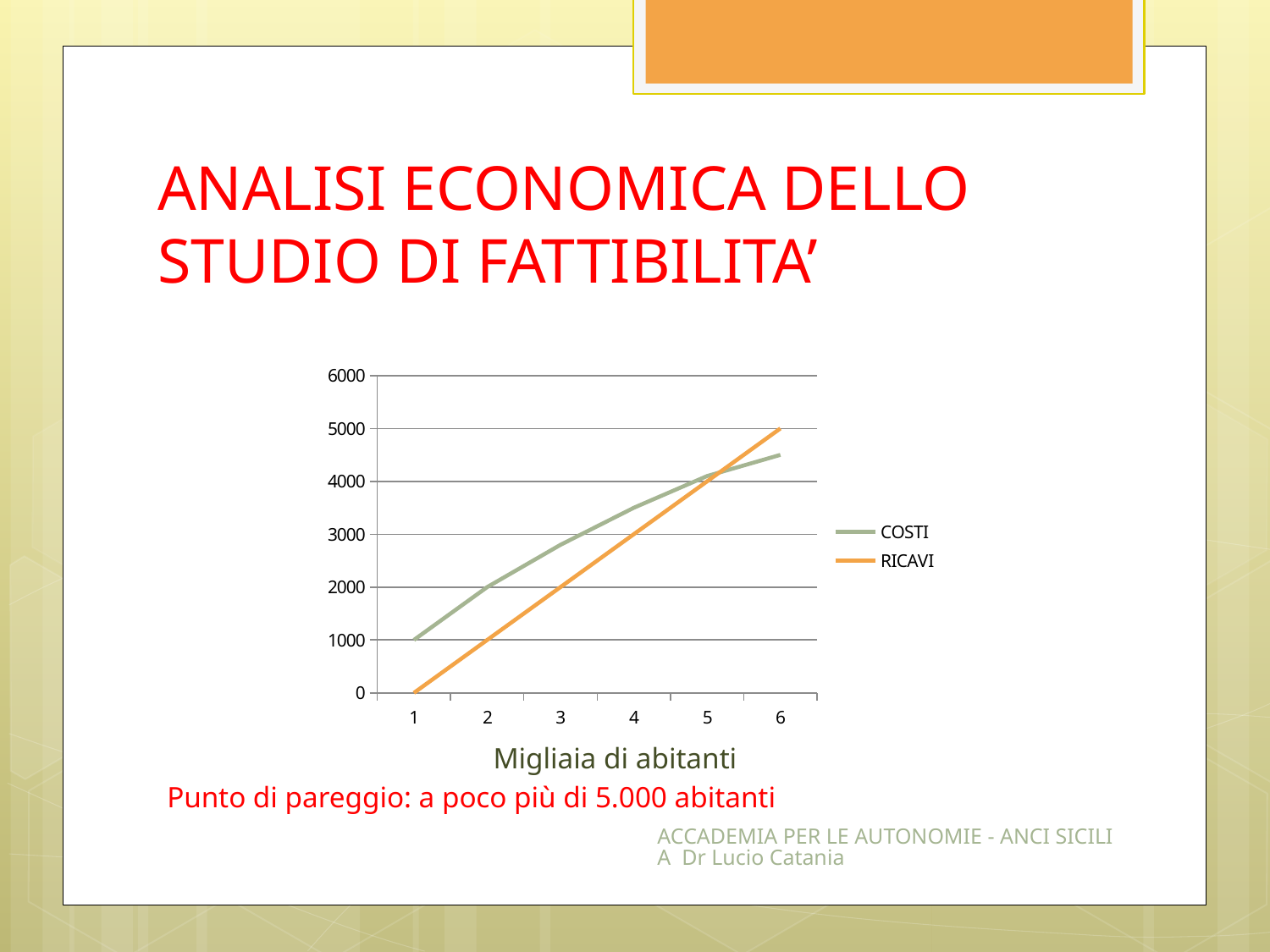
Do the RICAVI values rise or fall as x increases from 1 to 6? rise What is the value of RICAVI at x = 6? 5000 What is the value of COSTI at x = 1? 1000 At x = 2, which series has the larger value, COSTI or RICAVI? COSTI Is the value of COSTI at x = 3 greater or less than 3000? less What is the value of RICAVI at x = 1? 0 How many series does the legend list? 2 What is the label shown under the x axis of the chart? Migliaia di abitanti How many points are marked along the x axis? 6 What is the difference between COSTI and RICAVI at x = 1? 1000 Is the value of COSTI at x = 6 greater or less than 5000? less What kind of chart is shown on the slide? line chart